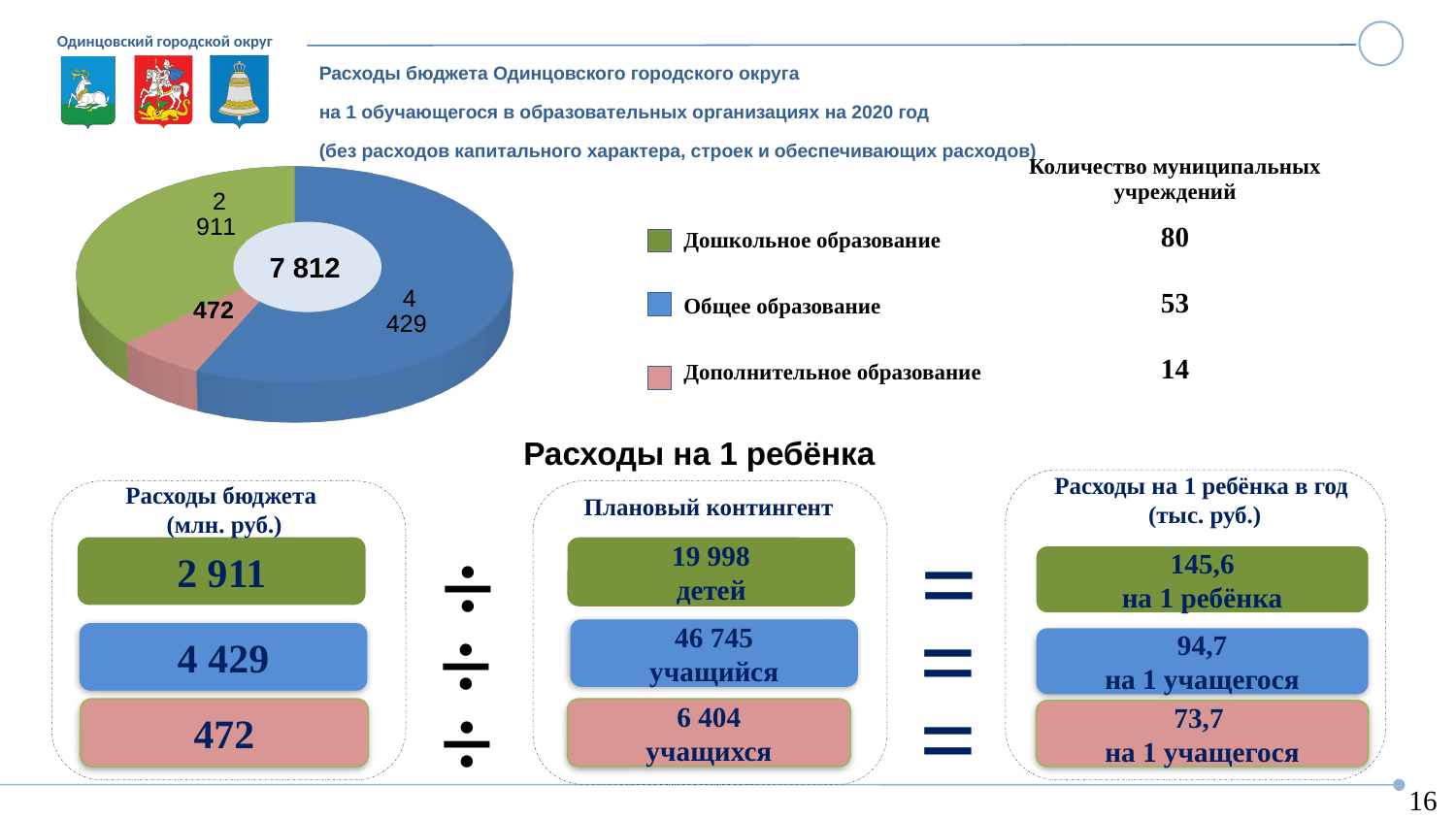
What is the value of the pie slice for Общее образование? 4 429 How many slices does the pie chart have? 3 What colour is the slice for Общее образование in the pie chart? blue Which category has the smallest slice in the pie chart? Дополнительное образование Which category has the largest slice in the pie chart? Общее образование What is the value of the pie slice for Дошкольное образование? 2 911 What total value is shown in the centre of the pie chart? 7 812 What is the value of the pie slice for Дополнительное образование? 472 Which is larger in the pie chart: Дошкольное образование or Дополнительное образование? Дошкольное образование What is the difference between the values for Дошкольное образование and Дополнительное образование in the pie chart? 2 439 What is the difference between the values for Общее образование and Дошкольное образование in the pie chart? 1 518 What type of chart is shown on the slide? pie chart